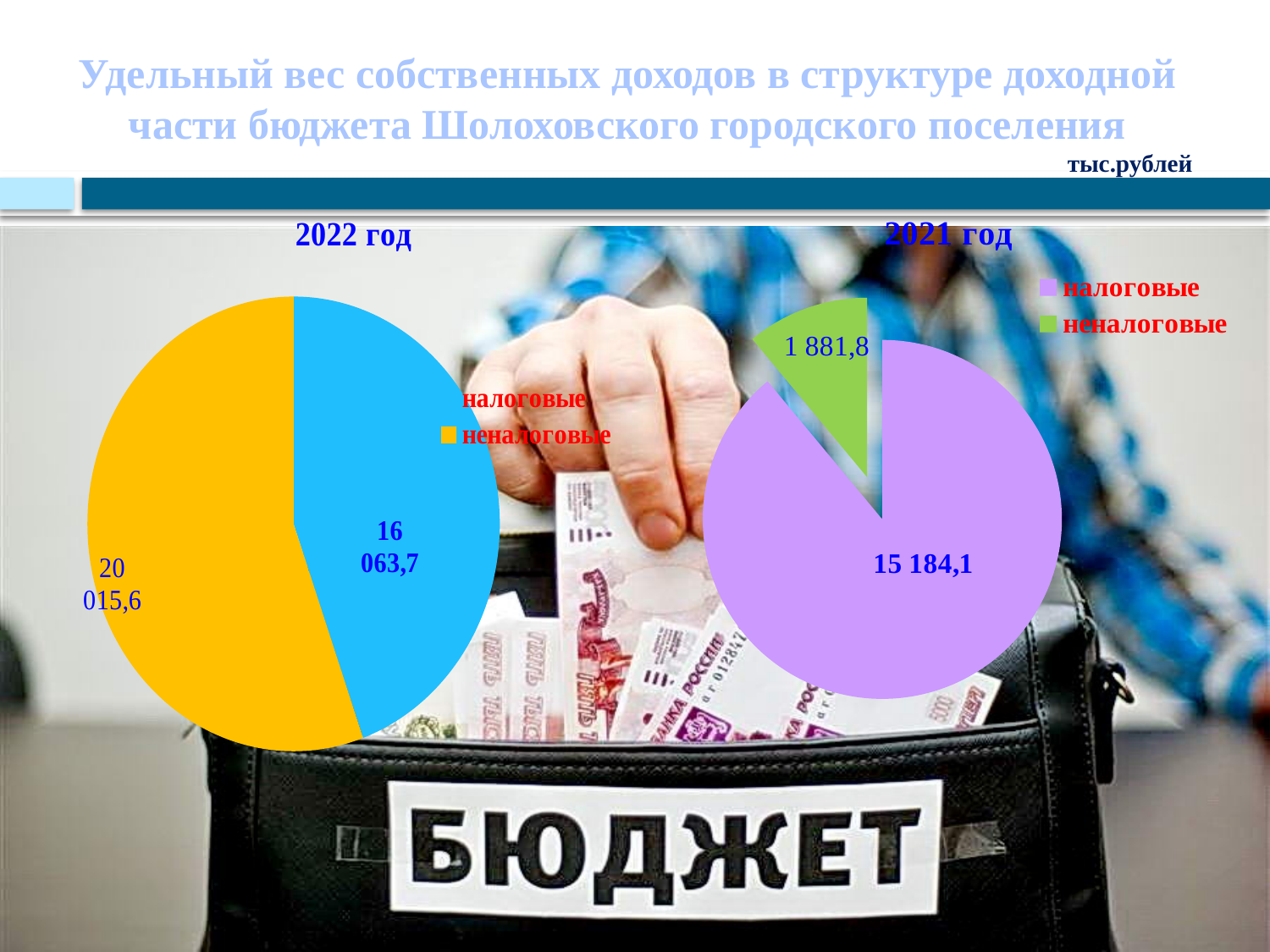
In the "2021 год" chart, what is the value for налоговые? 15 184,1 In the "2021 год" chart, what is the difference between налоговые and неналоговые? 13 302,3 In the "2021 год" chart, what colour is the неналоговые slice? green What kind of chart is the "2022 год" chart? pie chart In the "2022 год" chart, what is the difference between неналоговые and налоговые? 3 951,9 In the "2022 год" chart, which category is the smallest? налоговые In the "2021 год" chart, what is the value for неналоговые? 1 881,8 In the "2022 год" chart, what is the value for налоговые? 16 063,7 In the "2022 год" chart, what is the value for неналоговые? 20 015,6 In the "2022 год" chart, which is larger: налоговые or неналоговые? неналоговые In the "2021 год" chart, which category is the largest? налоговые How many slices does the "2021 год" chart have? 2